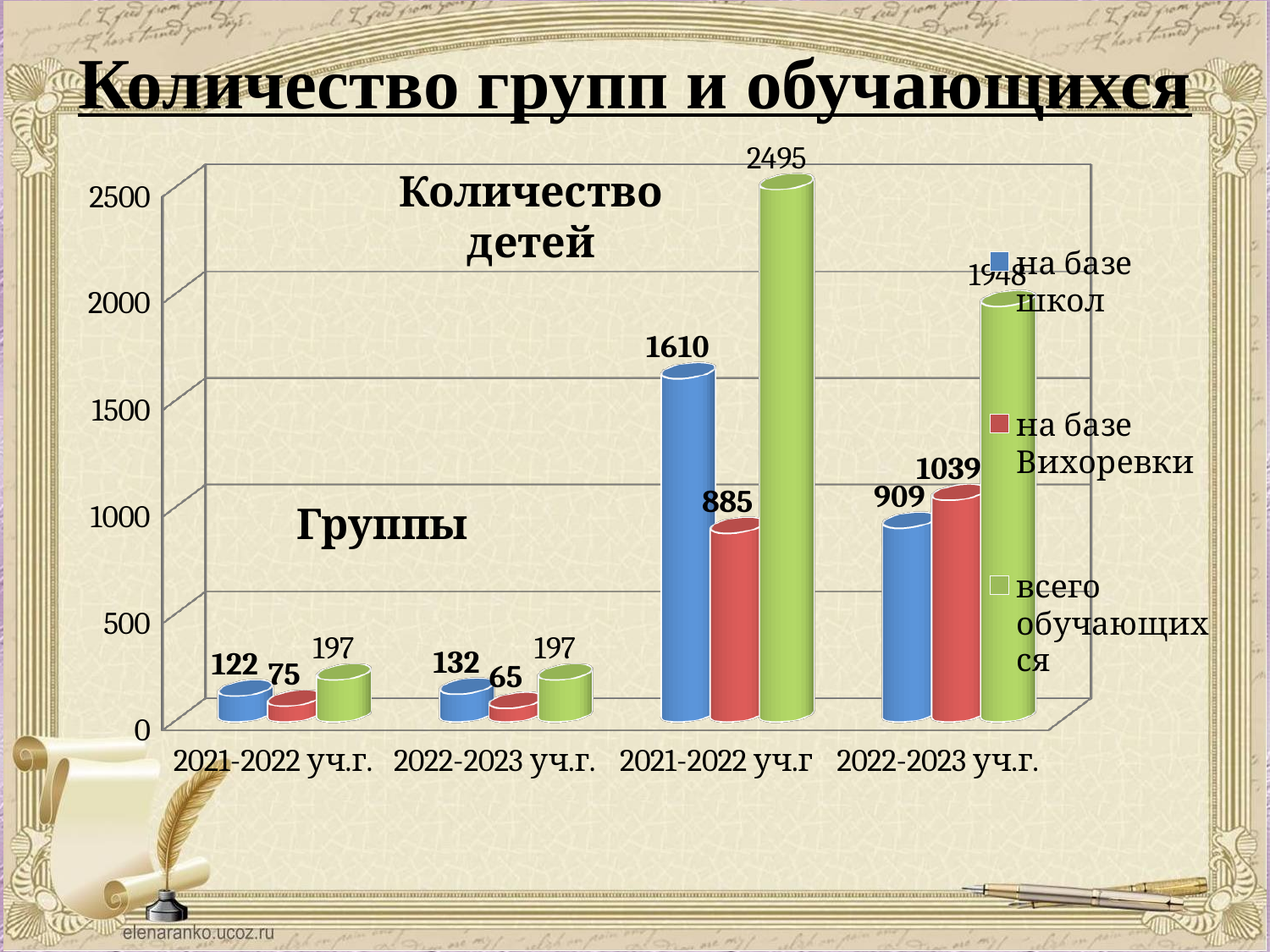
Is the "всего обучающихся" value for children in 2022-2023 уч.г. greater or less than 2000? less In the "Количество детей" part of the chart, what is the value for "на базе школ" in 2021-2022 уч.г? 1610 In the "Количество детей" part for 2022-2023 уч.г., which is larger: "на базе школ" or "на базе Вихоревки"? на базе Вихоревки How many categories are shown along the x axis of the chart? 4 How many series does the chart legend list? 3 What is the highest value shown on the chart? 2495 In the "Количество детей" part for 2021-2022 уч.г, what is the difference between "на базе школ" and "на базе Вихоревки"? 725 What is the lowest value shown on the chart? 65 In the "Группы" part of the chart, what is the value for "на базе Вихоревки" in 2022-2023 уч.г.? 65 What is the difference between the "всего обучающихся" values for children in 2021-2022 уч.г and 2022-2023 уч.г.? 547 In the "Количество детей" part of the chart, what is the value for "всего обучающихся" in 2022-2023 уч.г.? 1948 What kind of chart is shown on the slide? bar chart